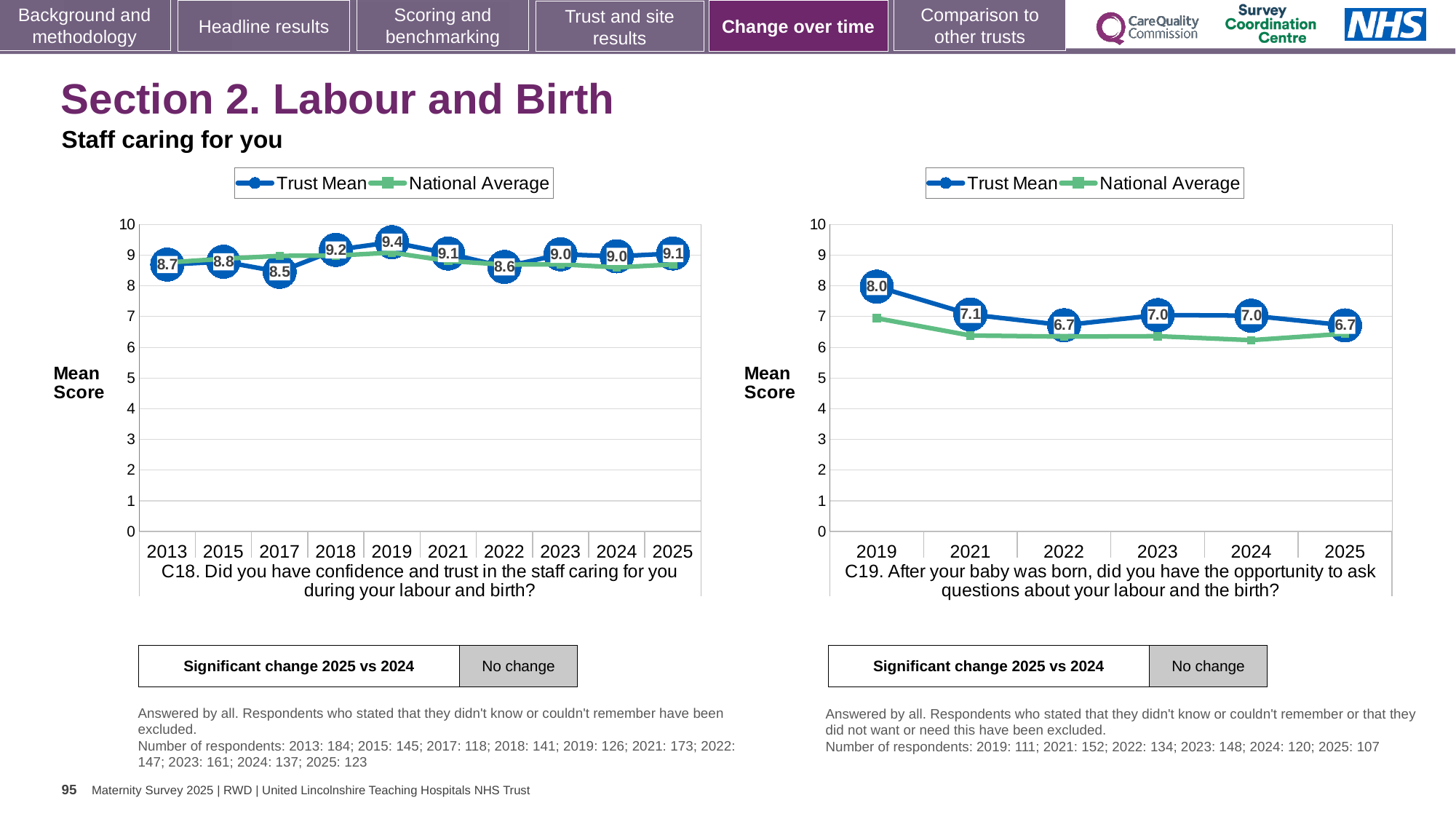
In the C19 chart (right), how many series does the legend list? 2 In the C19 chart (right), is the National Average value for 2019 greater or less than 8? less What kind of chart is the C19 chart (right)? Line chart In the C19 chart (right), which year has the highest Trust Mean score? 2019 In the C18 chart (left), what is the difference between the Trust Mean scores for 2019 and 2022? 0.8 In the C19 chart (right), what is the Trust Mean score for 2019? 8.0 In the C18 chart (left), which year has the lowest Trust Mean score? 2017 In the C18 chart (left), how many years are plotted on the x axis? 10 In the C18 chart (left), which year has the highest Trust Mean score? 2019 In the C18 chart (left), what is the Trust Mean score for 2017? 8.5 In the C18 chart (left), what is the Trust Mean score for 2019? 9.4 In the C19 chart (right), what is the difference between the Trust Mean scores for 2019 and 2025? 1.3